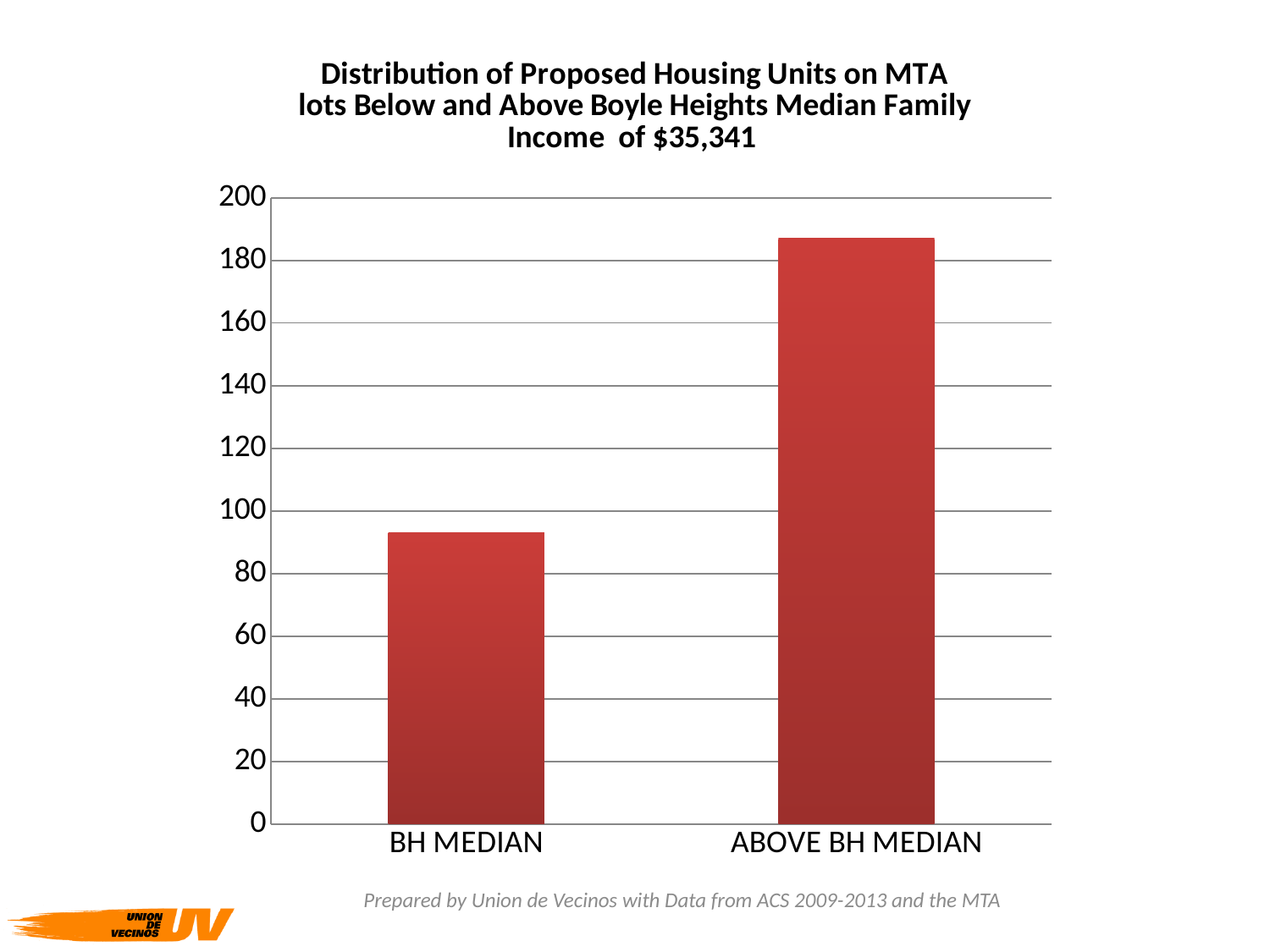
What is the maximum value shown on the vertical axis? 200 What median family income figure is stated in the chart title? $35,341 What kind of chart is shown on the slide? bar chart Which category has the lowest value? BH MEDIAN Which is larger, the value for BH MEDIAN or the value for ABOVE BH MEDIAN? ABOVE BH MEDIAN Which category has the highest value? ABOVE BH MEDIAN Is the value for BH MEDIAN greater or less than 100? less How many categories are plotted on the chart? 2 Is the value for BH MEDIAN greater or less than 80? greater Is the value for ABOVE BH MEDIAN greater or less than 180? greater